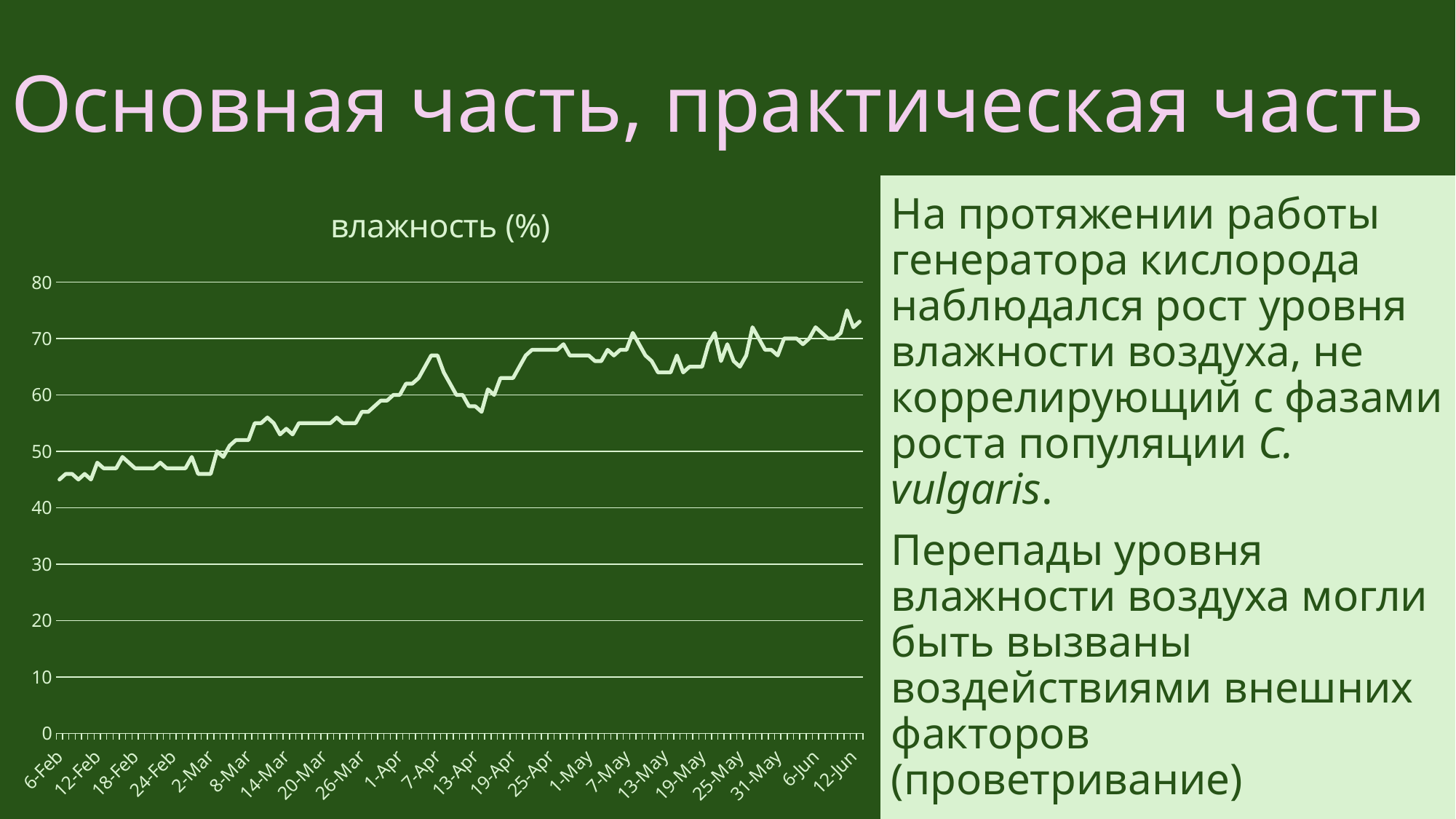
What is the title of the chart? влажность (%) How many lines (data series) are plotted in the chart? 1 Is the value for 14-Mar greater or less than 50? greater Is the value for 6-Feb greater or less than 50? less Which is larger, the value for 6-Feb or the value for 12-Jun? 12-Jun Is the value for 25-Apr greater or less than 60? greater What kind of chart is shown on the slide? line chart Do the values in the chart generally rise or fall from 6-Feb to 12-Jun? rise What is the highest value shown on the vertical axis of the chart? 80